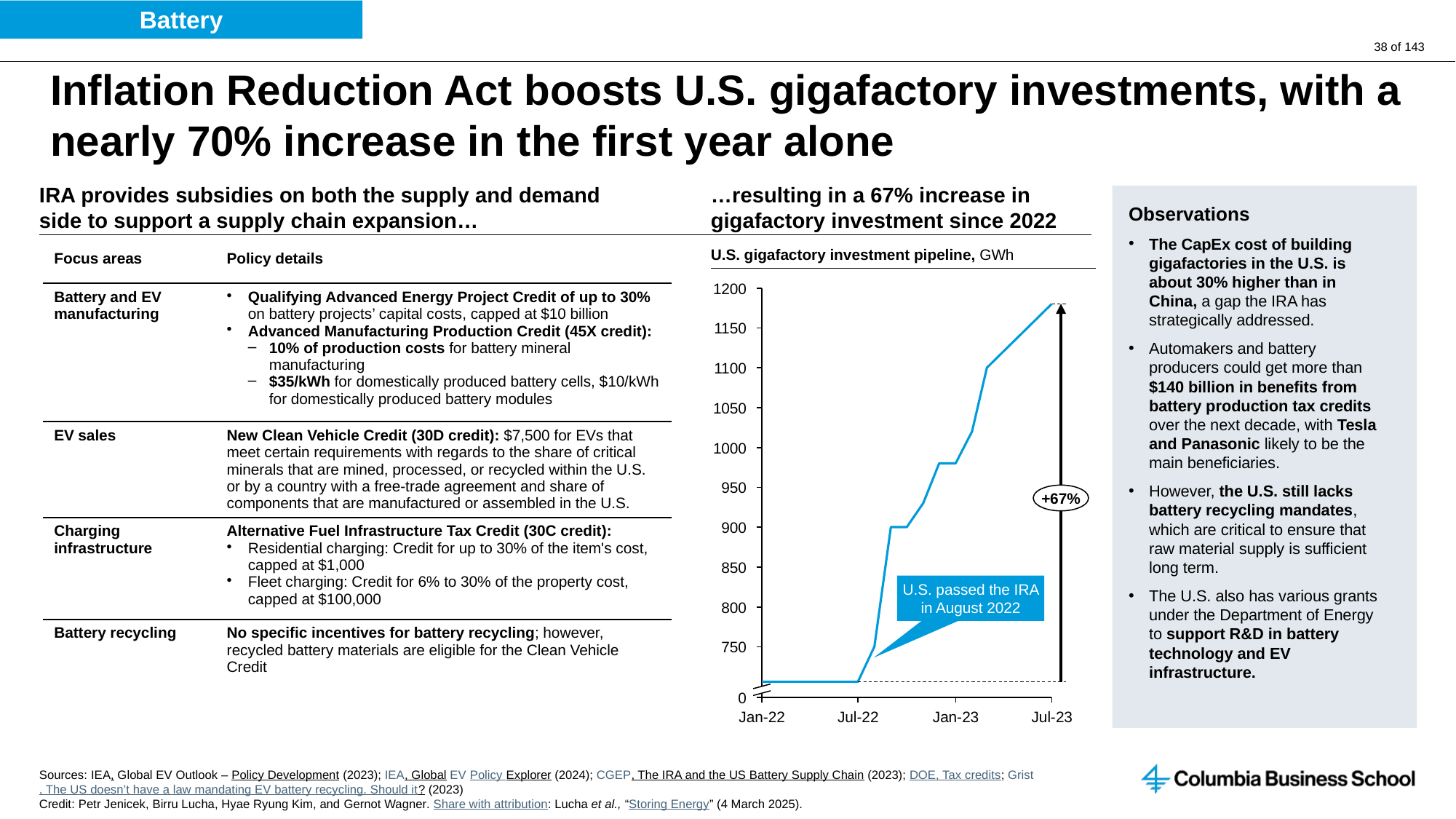
Do the values in the chart rise or fall from Jan-22 to Jul-23? rise How many date labels are shown on the x axis? 4 What is the highest value shown on the y axis? 1200 Is the value at Jul-23 greater or less than 1150? greater Is the value at Jul-22 greater or less than 750? less What kind of chart is shown on the slide? line chart Which of the labelled dates on the x axis has the highest value? Jul-23 Which is larger, the value at Jan-22 or the value at Jul-23? Jul-23 Is the value at Jan-22 greater or less than 800? less What is the title of the chart? U.S. gigafactory investment pipeline What unit is the chart's data measured in? GWh What percentage increase is labelled on the chart? +67%